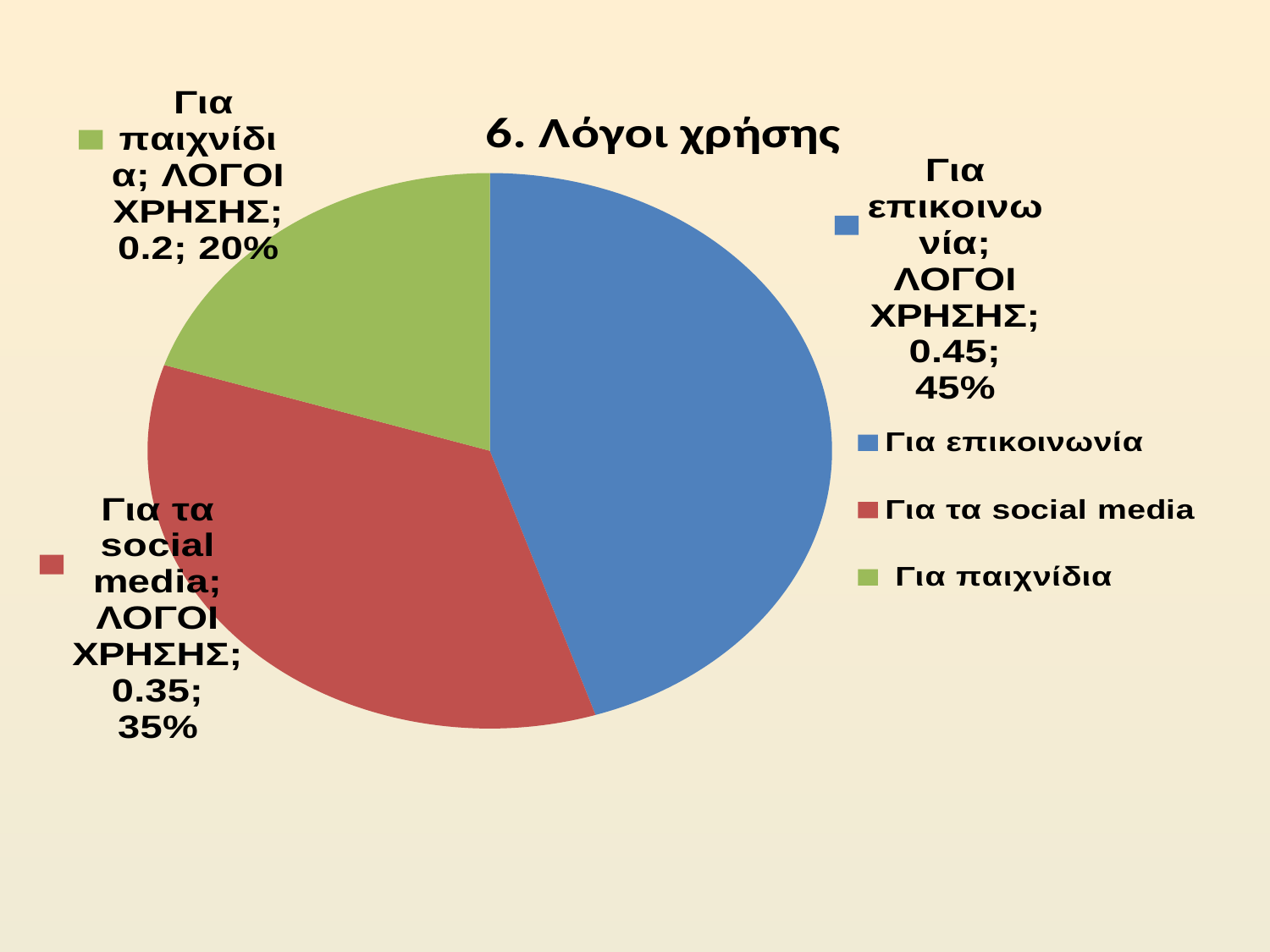
What value is printed for 'Για παιχνίδια'? 0.2 What value is printed for 'Για τα social media'? 0.35 What percentage share does the slice 'Για παιχνίδια' have? 20% What percentage share does the slice 'Για επικοινωνία' have? 45% What percentage share does the slice 'Για τα social media' have? 35% What kind of chart is shown on the slide? Pie chart What is the difference in percentage points between 'Για επικοινωνία' and 'Για παιχνίδια'? 25% Which category has the largest slice of the pie? Για επικοινωνία What is the title of the chart? 6. Λόγοι χρήσης Which is larger, the slice for 'Για τα social media' or the slice for 'Για παιχνίδια'? Για τα social media Which category has the smallest slice of the pie? Για παιχνίδια How many categories does the pie chart have? 3